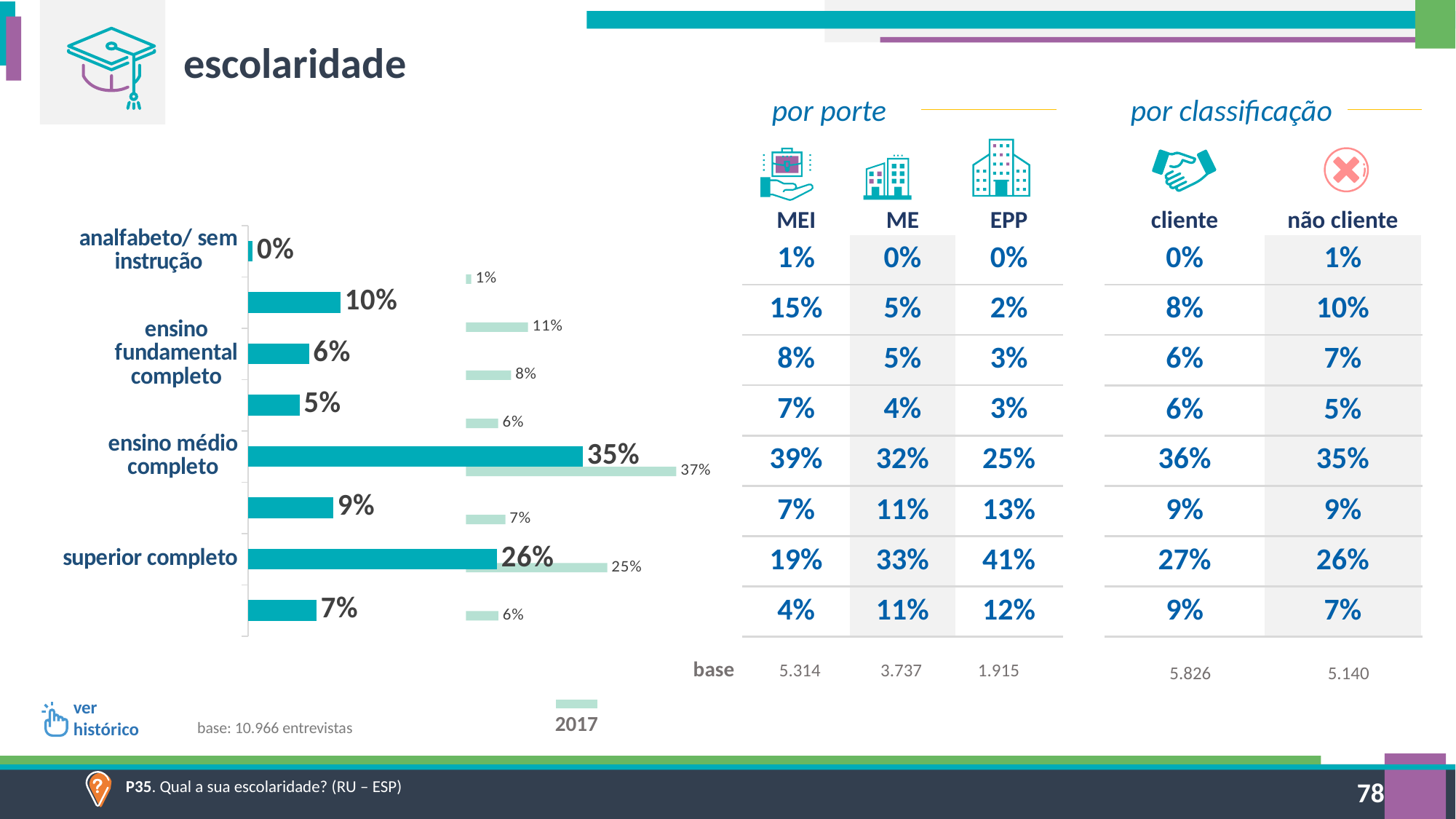
What kind of chart is shown on the slide? bar chart What is the difference between the teal bars for 'ensino médio completo' and 'superior completo'? 9 percentage points What is the value of the teal bar for 'ensino médio completo'? 35% How many teal bars are plotted in the chart? 8 What is the 2017 value (light green bar) for 'superior completo'? 25% Which category has the lowest teal bar? analfabeto/ sem instrução Which category has the highest teal bar? ensino médio completo What is the 2017 value (light green bar) for 'ensino médio completo'? 37% What is the value of the teal bar for 'superior completo'? 26% What is the value of the teal bar for 'analfabeto/ sem instrução'? 0% Which is larger: the teal bar for 'superior completo' or for 'ensino fundamental completo'? superior completo What is the value of the teal bar for 'ensino fundamental completo'? 6%